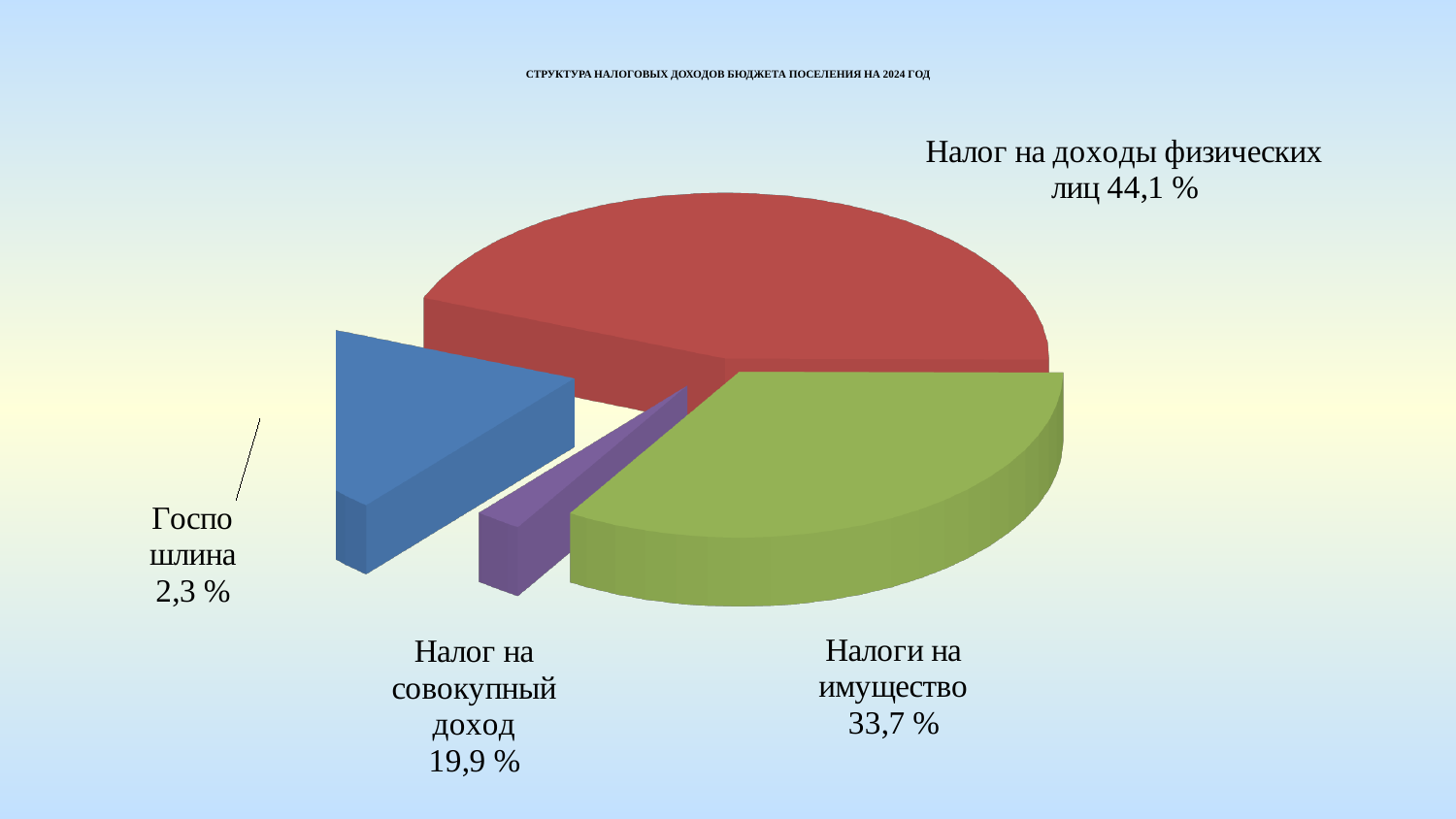
What is the difference in percentage points between Налог на доходы физических лиц and Налоги на имущество? 10,4 What is the share for Госпошлина? 2,3 % What kind of chart is shown on the slide? Pie chart What is the share for Налоги на имущество? 33,7 % How many slices does the pie chart have? 4 What is the share for Налог на совокупный доход? 19,9 % Which category has the smallest share of the pie? Госпошлина Which is larger, the share for Налоги на имущество or the share for Налог на совокупный доход? Налоги на имущество What is the title of the chart? СТРУКТУРА НАЛОГОВЫХ ДОХОДОВ БЮДЖЕТА ПОСЕЛЕНИЯ НА 2024 ГОД What colour is the slice for Налоги на имущество? Green Which category has the largest share of the pie? Налог на доходы физических лиц What is the share for Налог на доходы физических лиц? 44,1 %